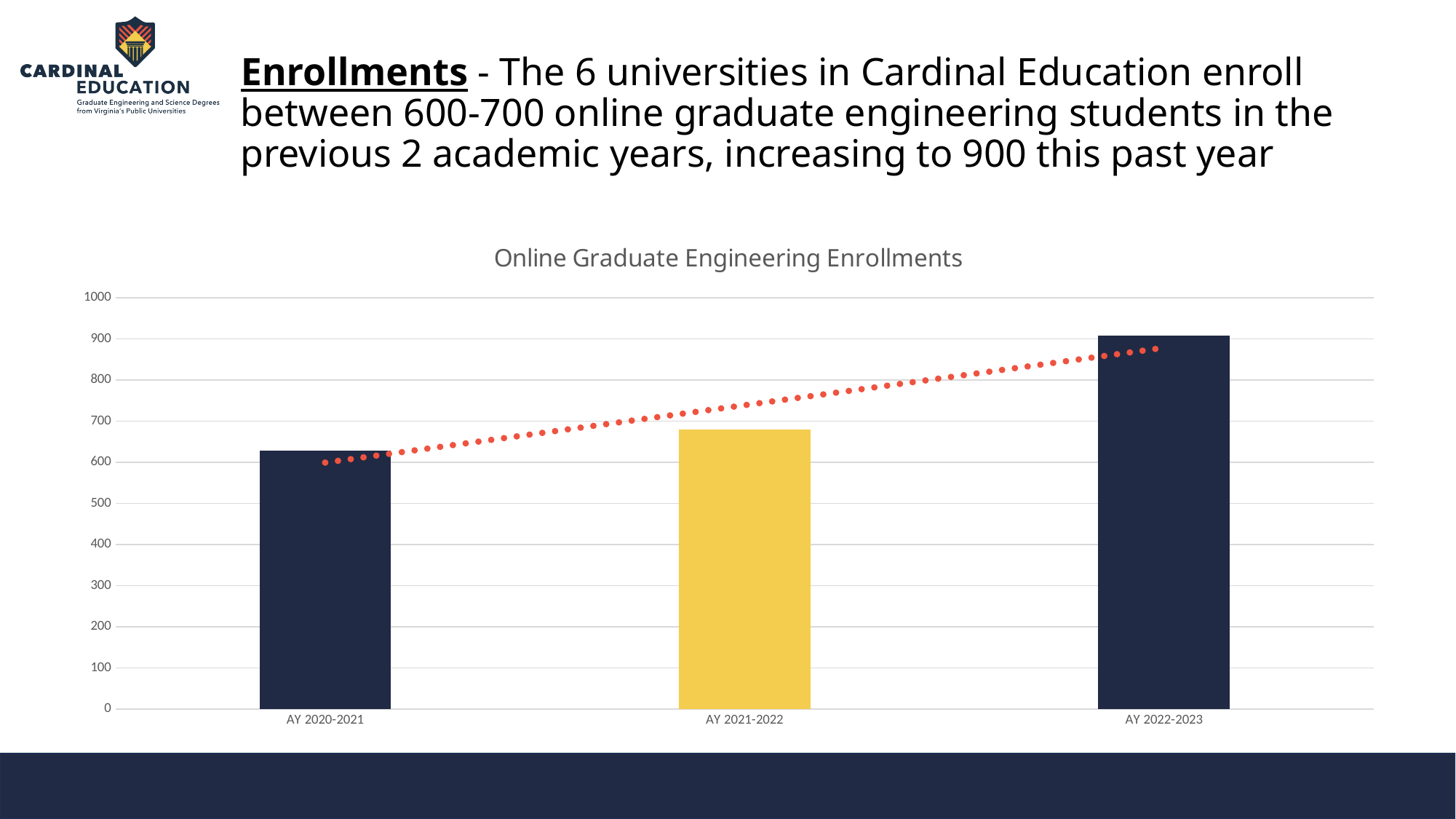
What is the title of the chart? Online Graduate Engineering Enrollments Is the value for AY 2022-2023 greater or less than 800? greater Is the value for AY 2020-2021 greater or less than 600? greater Do the enrollment values rise or fall from AY 2020-2021 to AY 2022-2023? Rise How many academic years are shown on the x axis of the chart? 3 What colour is the bar for AY 2021-2022? Yellow Is the value for AY 2022-2023 greater or less than 1000? less Which is larger, the enrollment for AY 2020-2021 or for AY 2021-2022? AY 2021-2022 What type of chart is shown on the slide? Bar chart Which academic year has the highest enrollment in the chart? AY 2022-2023 Which academic year has the lowest enrollment in the chart? AY 2020-2021